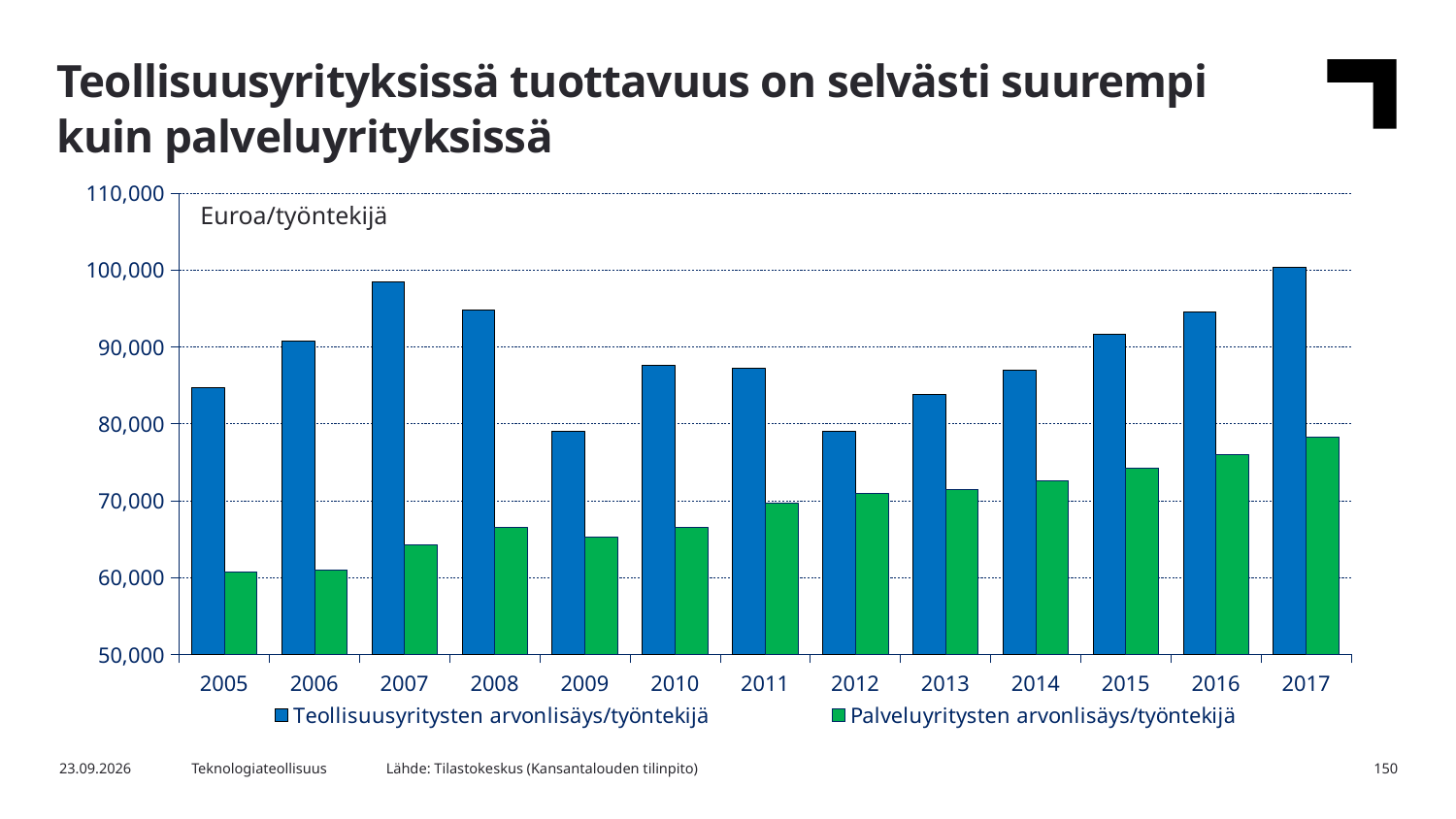
How many years are shown on the x axis? 13 Is the value for Teollisuusyritysten arvonlisäys/työntekijä in 2009 greater or less than 80,000? less Is the value for Palveluyritysten arvonlisäys/työntekijä in 2017 greater or less than 80,000? less How many series does the legend list? 2 What kind of chart is shown on the slide? bar chart Is the value for Teollisuusyritysten arvonlisäys/työntekijä in 2017 greater or less than 100,000? greater What unit label is shown inside the plot area of the chart? Euroa/työntekijä Which year has the highest value for Palveluyritysten arvonlisäys/työntekijä? 2017 Does the value for Palveluyritysten arvonlisäys/työntekijä generally rise or fall from 2005 to 2017? rise Which year has the highest value for Teollisuusyritysten arvonlisäys/työntekijä? 2017 Which is larger, the Teollisuusyritysten arvonlisäys/työntekijä value in 2007 or in 2008? 2007